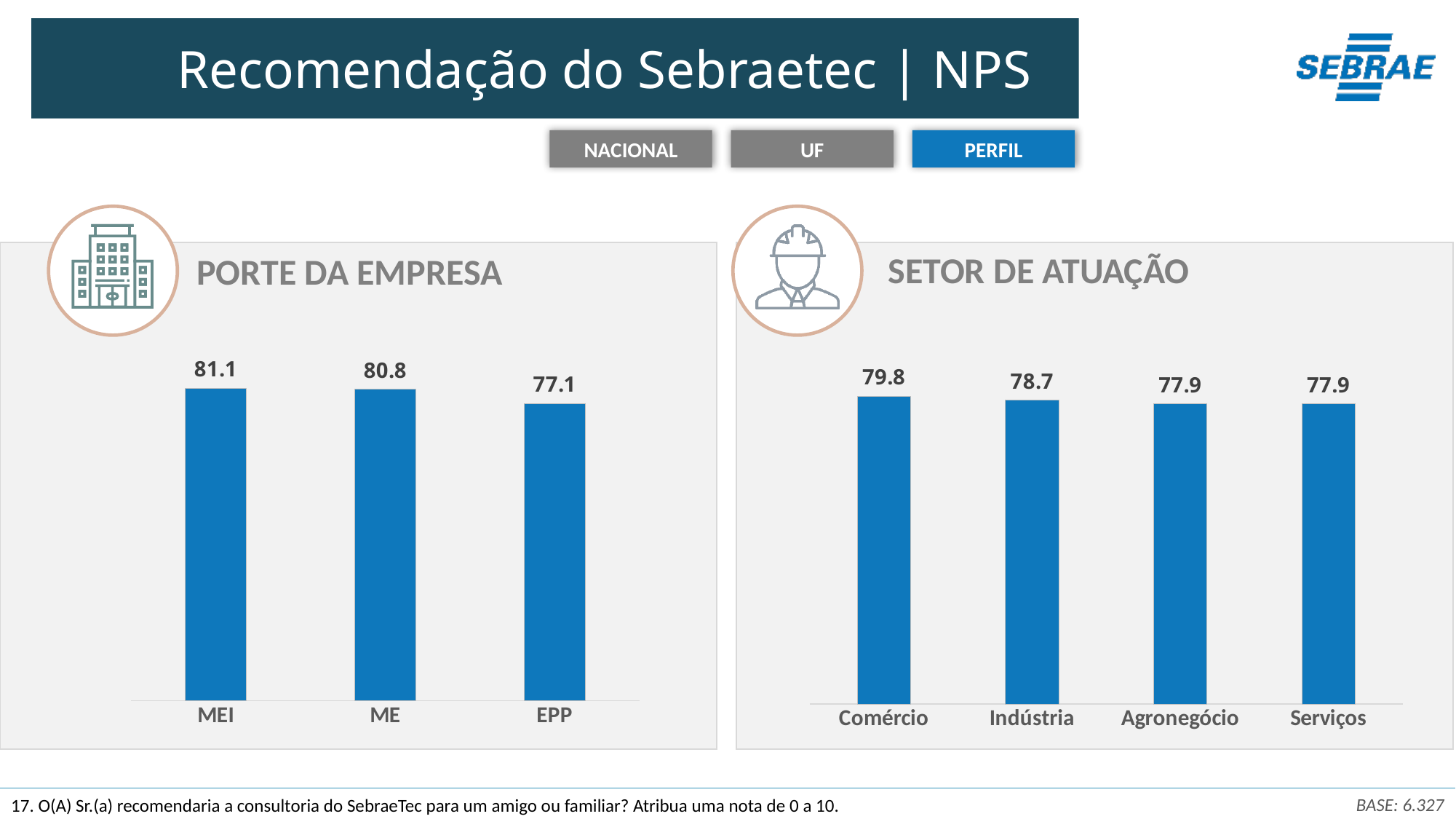
In the PORTE DA EMPRESA chart, what is the value for EPP? 77.1 In the SETOR DE ATUAÇÃO chart, how many categories are shown? 4 In the SETOR DE ATUAÇÃO chart, what is the value for Comércio? 79.8 In the PORTE DA EMPRESA chart, do the values rise or fall from MEI to EPP? Fall In the SETOR DE ATUAÇÃO chart, what is the value for Indústria? 78.7 In the PORTE DA EMPRESA chart, which category has the lowest value? EPP In the PORTE DA EMPRESA chart, what is the value for MEI? 81.1 In the PORTE DA EMPRESA chart, how many categories are shown? 3 What kind of chart is the SETOR DE ATUAÇÃO chart? Bar chart In the PORTE DA EMPRESA chart, what is the difference between the values for MEI and EPP? 4.0 In the SETOR DE ATUAÇÃO chart, which category has the highest value? Comércio In the SETOR DE ATUAÇÃO chart, what is the difference between the values for Comércio and Indústria? 1.1